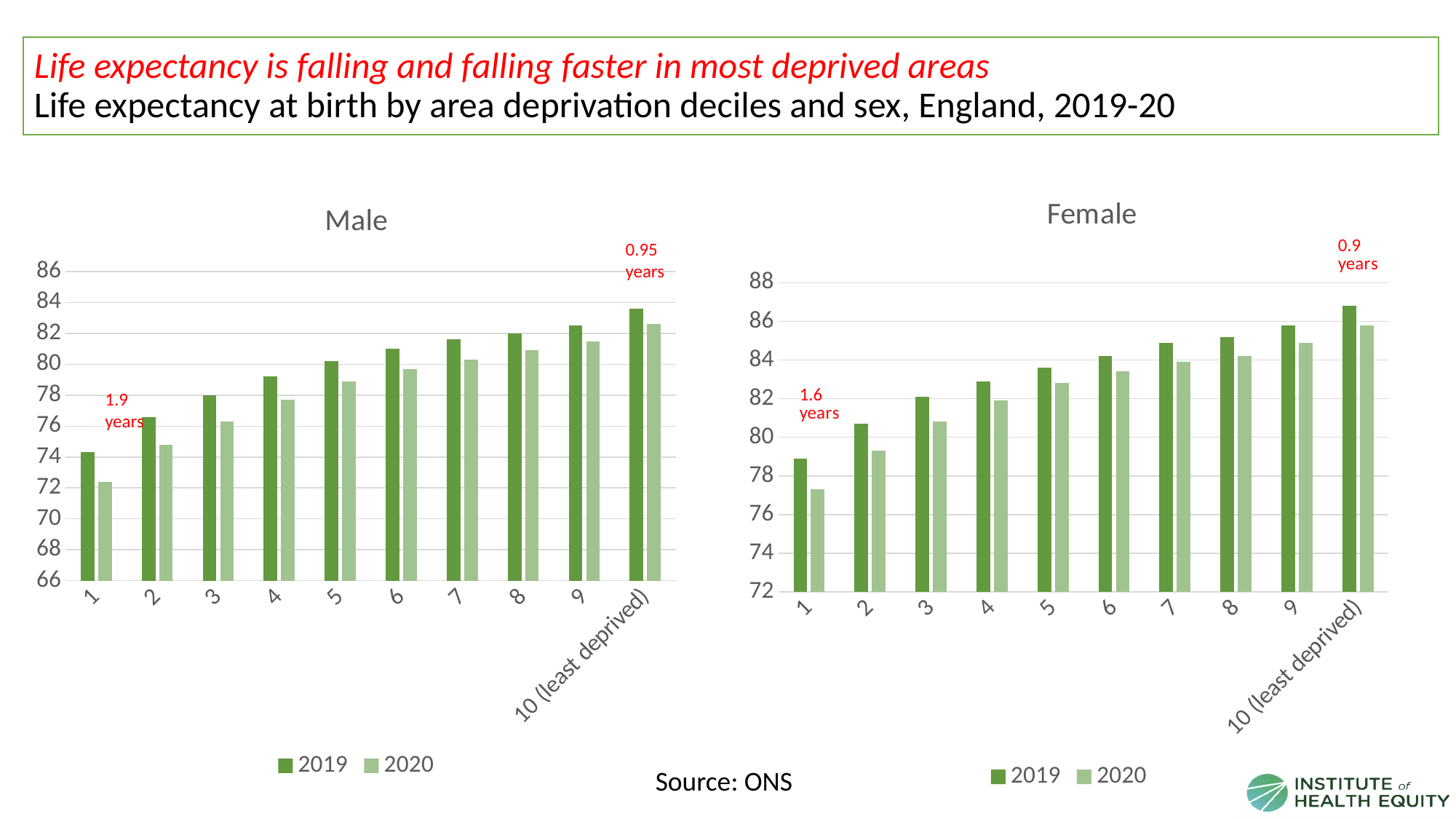
In the Female chart, what is the annotated fall in life expectancy for decile 1 between 2019 and 2020? 1.6 years In the Male chart, is the 2020 value for decile 1 greater or less than 74? less In the Female chart, do 2019 life expectancy values rise or fall as the deprivation decile increases from 1 to 10? rise What type of chart is the Male chart? bar chart How many deprivation deciles are shown on the x axis of the Male chart? 10 In the Female chart, what is the annotated fall in life expectancy for decile 10 (least deprived) between 2019 and 2020? 0.9 years How many series does the legend of the Female chart list? 2 In the Male chart, which decile has the highest 2019 life expectancy? 10 (least deprived) In the Female chart, which decile has the lowest 2020 life expectancy? 1 In the Male chart, what is the annotated fall in life expectancy for decile 10 (least deprived) between 2019 and 2020? 0.95 years In the Female chart, is the 2019 value for decile 10 (least deprived) greater or less than 86? greater In the Male chart, what is the annotated fall in life expectancy for decile 1 between 2019 and 2020? 1.9 years